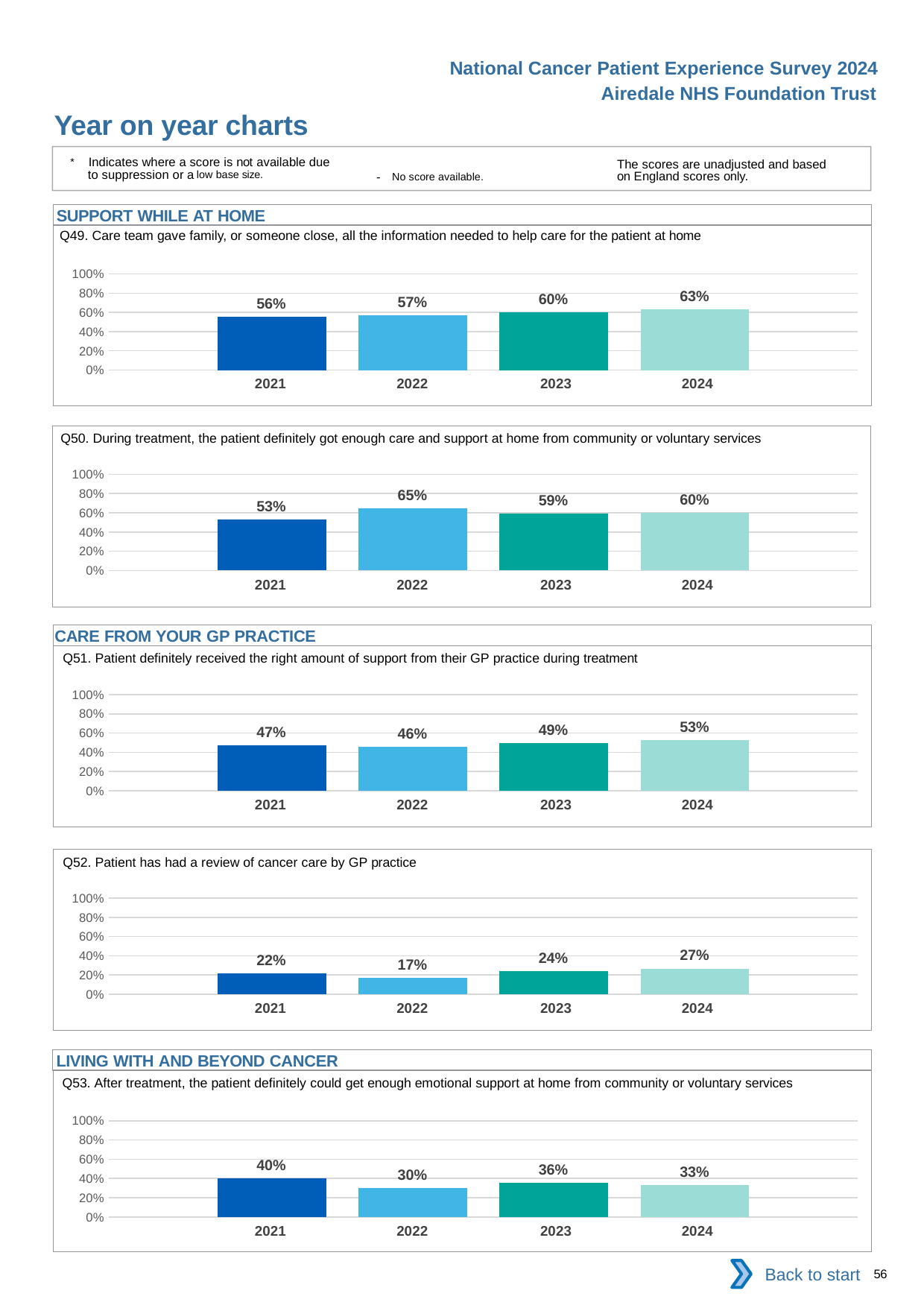
In the Q50 chart, what is the difference between the 2022 and 2021 values? 12 percentage points In the Q51 chart, which year has the lowest value? 2022 In the Q53 chart, what is the difference between the 2021 and 2022 values? 10 percentage points What kind of chart is the Q50 chart? bar chart In the Q50 chart, which year has the highest value? 2022 In the Q51 chart, what is the value for 2023? 49% In the Q49 chart, what is the value for 2024? 63% In the Q52 chart, what is the value for 2022? 17% How many years are shown in the Q52 chart? 4 In the Q52 chart, is the value for 2024 greater or less than 40%? less In the Q53 chart, which is larger, the value for 2021 or the value for 2023? 2021 In the Q49 chart, do the values rise or fall from 2021 to 2024? rise